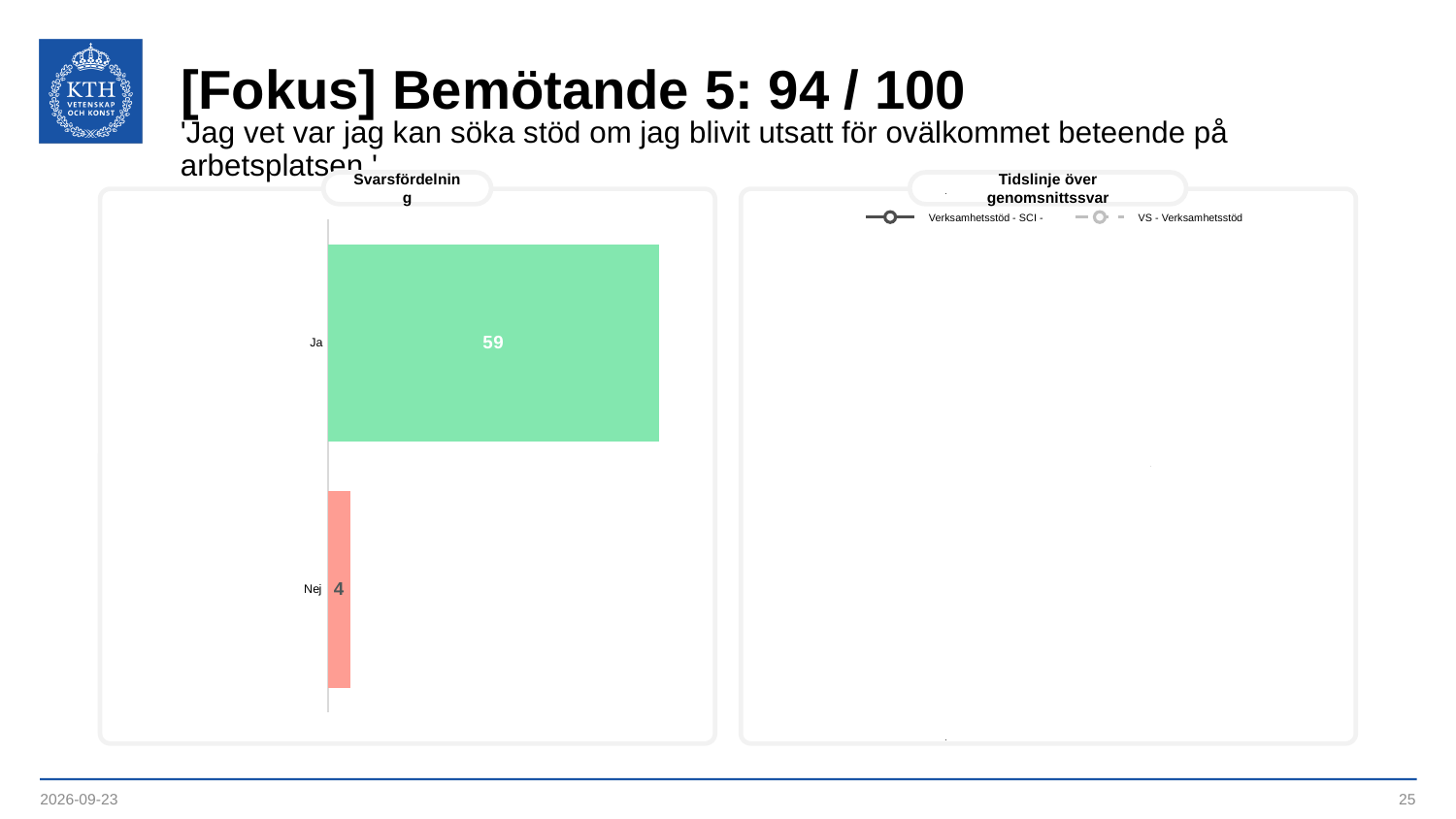
In the 'Svarsfördelning' chart, what is the difference between the values for 'Ja' and 'Nej'? 55 In the 'Svarsfördelning' chart, what colour is the bar for 'Nej'? Salmon pink (light red) How many series does the legend of the 'Tidslinje över genomsnittssvar' chart list? 2 In the 'Svarsfördelning' chart, which is larger, the value for 'Ja' or the value for 'Nej'? Ja In the 'Svarsfördelning' chart, what is the value for 'Ja'? 59 In the 'Svarsfördelning' chart, which category has the lowest value? Nej In the 'Svarsfördelning' chart, which category has the highest value? Ja How many categories are shown in the 'Svarsfördelning' chart? 2 What is the title of the chart on the left side of the slide? Svarsfördelning What kind of chart is the 'Svarsfördelning' chart? Bar chart In the 'Svarsfördelning' chart, what is the value for 'Nej'? 4